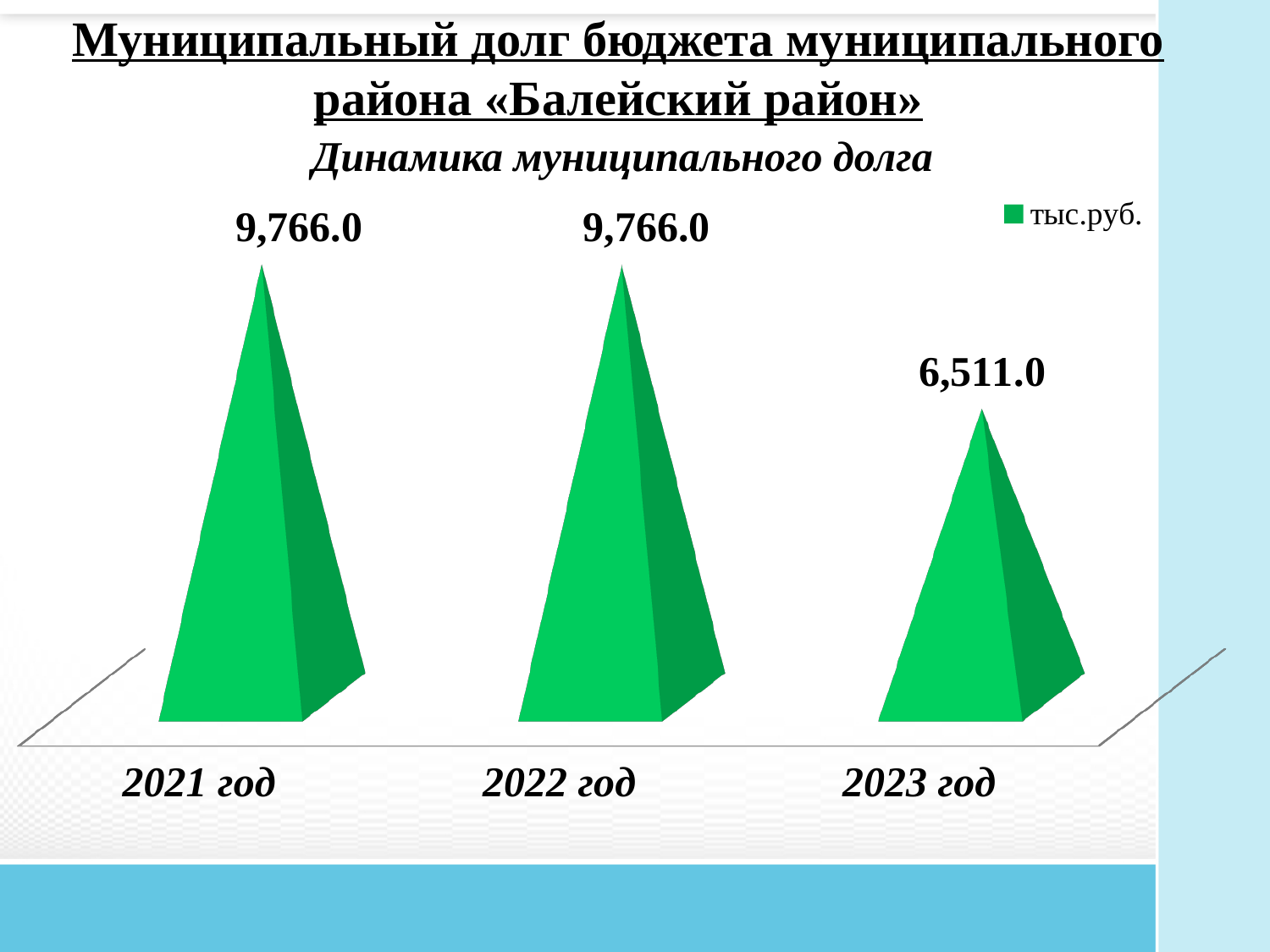
Do the values rise or fall from 2022 год to 2023 год? fall What is the municipal debt value for 2021 год? 9,766.0 How many series does the legend list? 1 What is the value shown for 2022 год? 9,766.0 Which year has the lowest municipal debt? 2023 год What is the municipal debt value for 2023 год? 6,511.0 What kind of chart is shown on the slide? bar chart Which is larger, the value for 2021 год or the value for 2023 год? 2021 год What is the difference between the values for 2022 год and 2023 год? 3,255.0 What is the subtitle of the chart? Динамика муниципального долга How many years are shown on the chart? 3 What unit is given in the chart legend? тыс.руб.